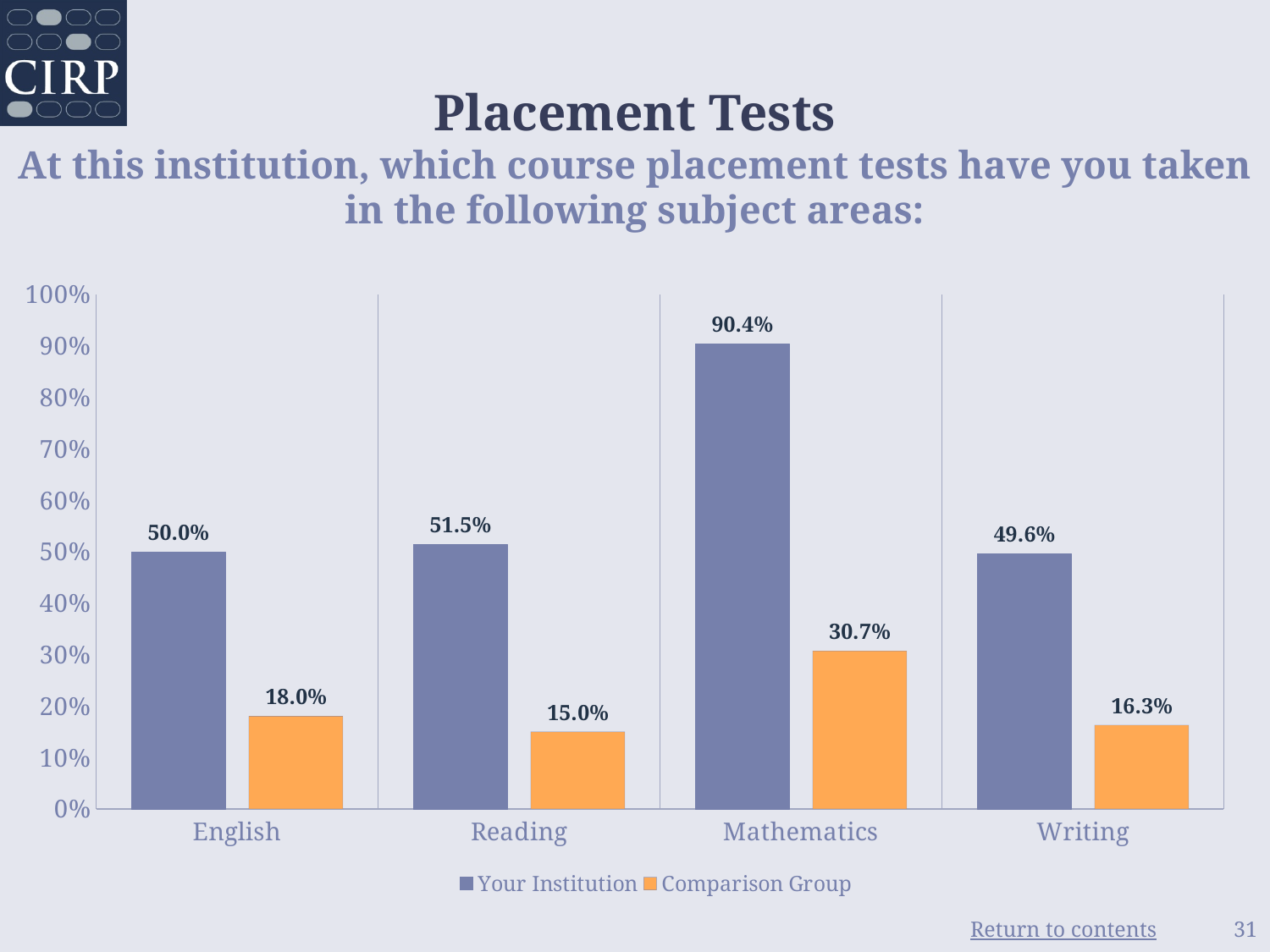
What kind of chart is shown on the slide? Bar chart What is the title of the chart? Placement Tests How many series does the legend list? 2 What is the value for Your Institution in Writing? 49.6% How many subject areas are shown on the x axis? 4 Which is larger: the Comparison Group value for English or for Writing? English Which subject area has the lowest value for the Comparison Group? Reading What is the value for Your Institution in Mathematics? 90.4% What is the value for the Comparison Group in Reading? 15.0% Which subject area has the highest value for Your Institution? Mathematics What is the difference between Your Institution and the Comparison Group in Mathematics? 59.7% Is the value for Your Institution in Reading greater or less than 40%? greater